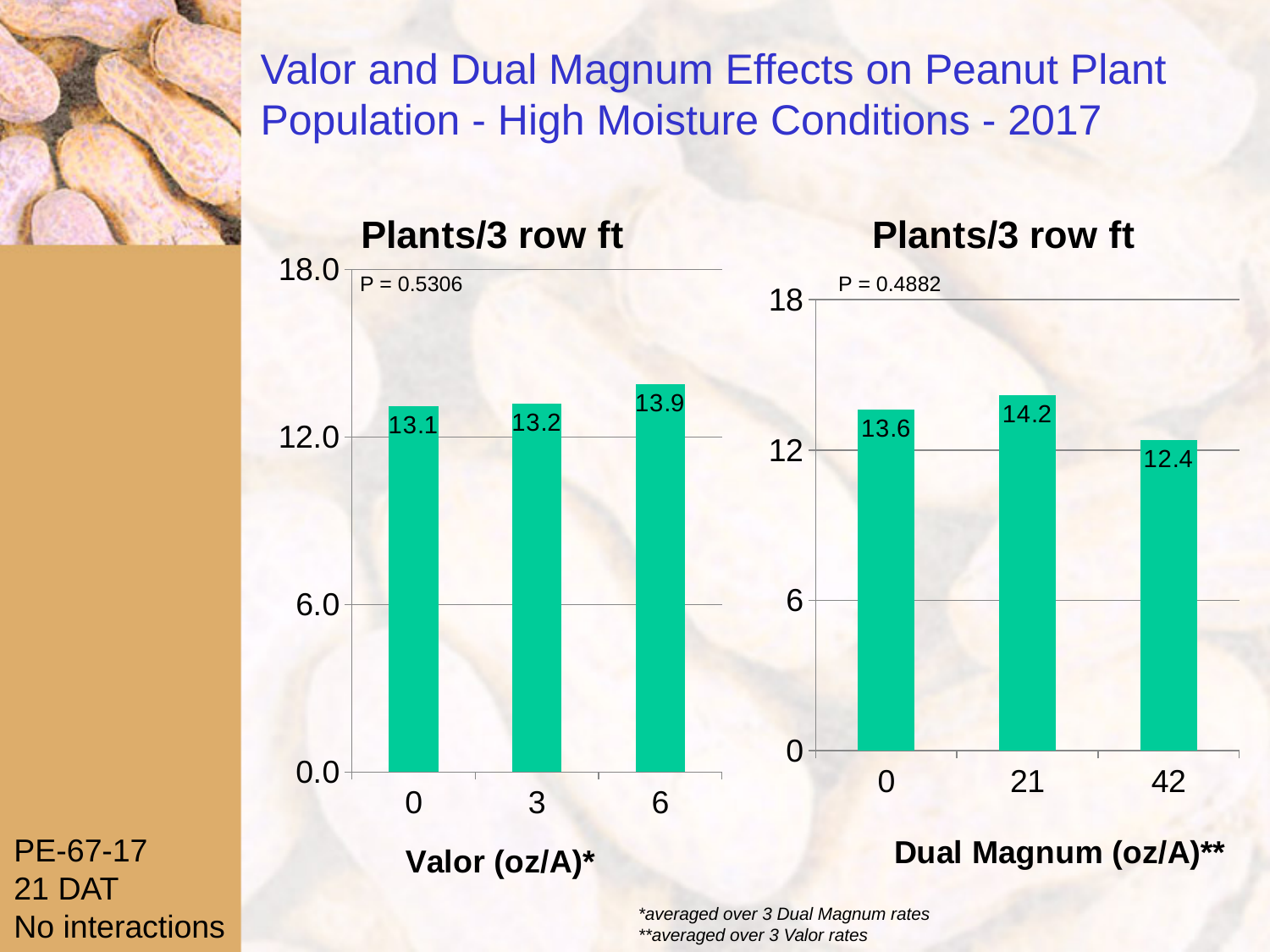
In the left chart (Valor), what is the value for the 6 oz/A rate? 13.9 In the left chart (Valor), do the values rise or fall as the rate increases from 0 to 6 oz/A? Rise In the right chart (Dual Magnum), what is the value for the 21 oz/A rate? 14.2 In the left chart (Valor), what is the difference between the values for the 6 and 0 oz/A rates? 0.8 In the right chart (Dual Magnum), which rate has the lowest plants/3 row ft? 42 What P value is shown on the right chart (Dual Magnum)? P = 0.4882 In the right chart (Dual Magnum), which is larger, the value for 0 oz/A or the value for 42 oz/A? 0 oz/A In the left chart (Valor), which rate has the highest plants/3 row ft? 6 In the left chart (Valor), what is the value for the 0 oz/A rate? 13.1 What kind of chart is the right chart (Dual Magnum)? Bar chart In the right chart (Dual Magnum), what is the difference between the values for the 21 and 42 oz/A rates? 1.8 How many rates are plotted in the left chart (Valor)? 3